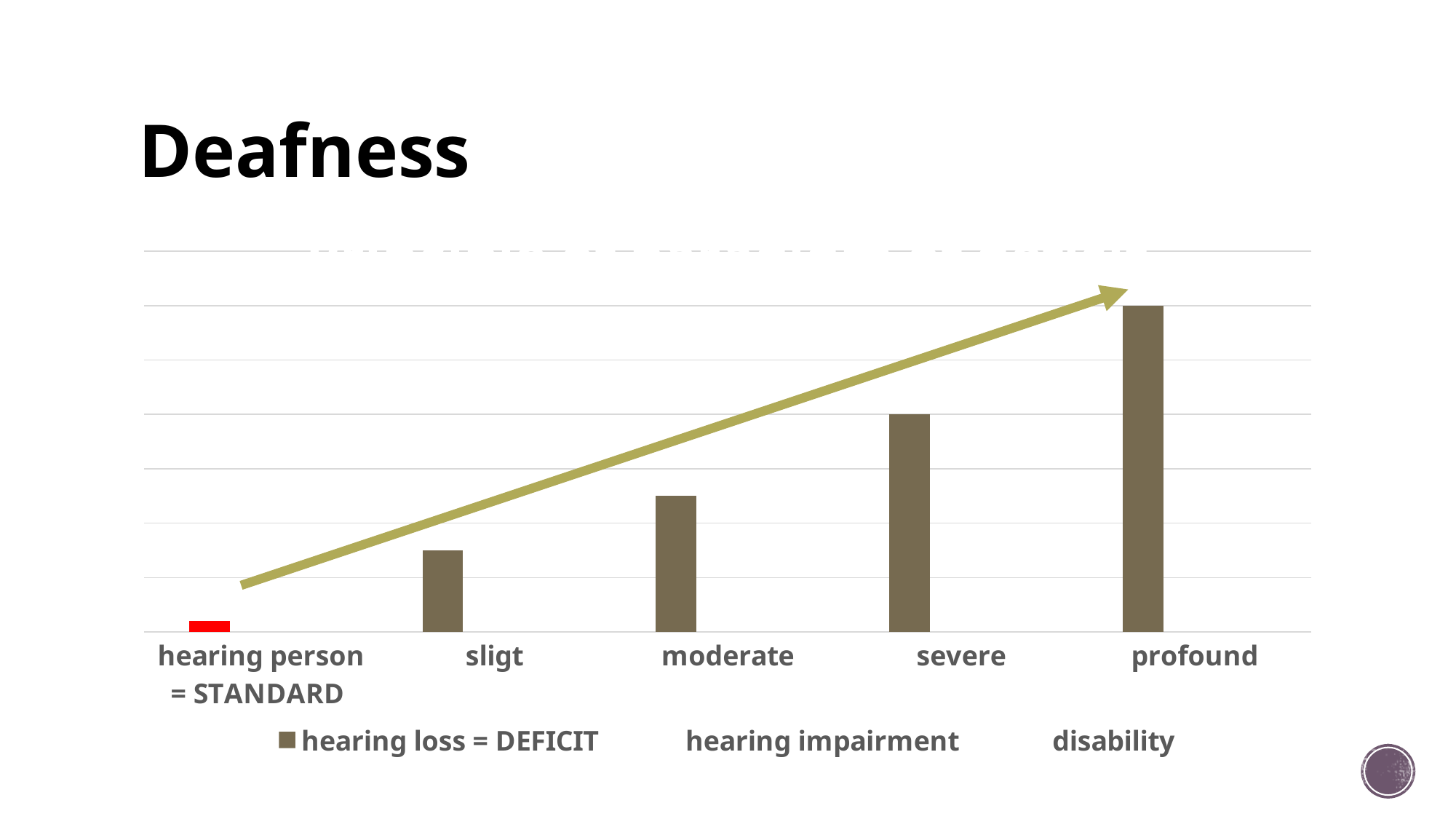
Which category has the tallest bar in the chart? profound What is the title of the slide containing the chart? Deafness Which category has the shortest bar in the chart? hearing person = STANDARD What colour is the bar for hearing person = STANDARD? red What kind of chart is shown on the slide? bar chart Which bar is taller, sligt or profound? profound Do the bar heights rise or fall from left to right along the x axis? rise How many categories are shown on the x axis of the chart? 5 Which bar is shorter, hearing person = STANDARD or sligt? hearing person = STANDARD Which bar is taller, severe or moderate? severe